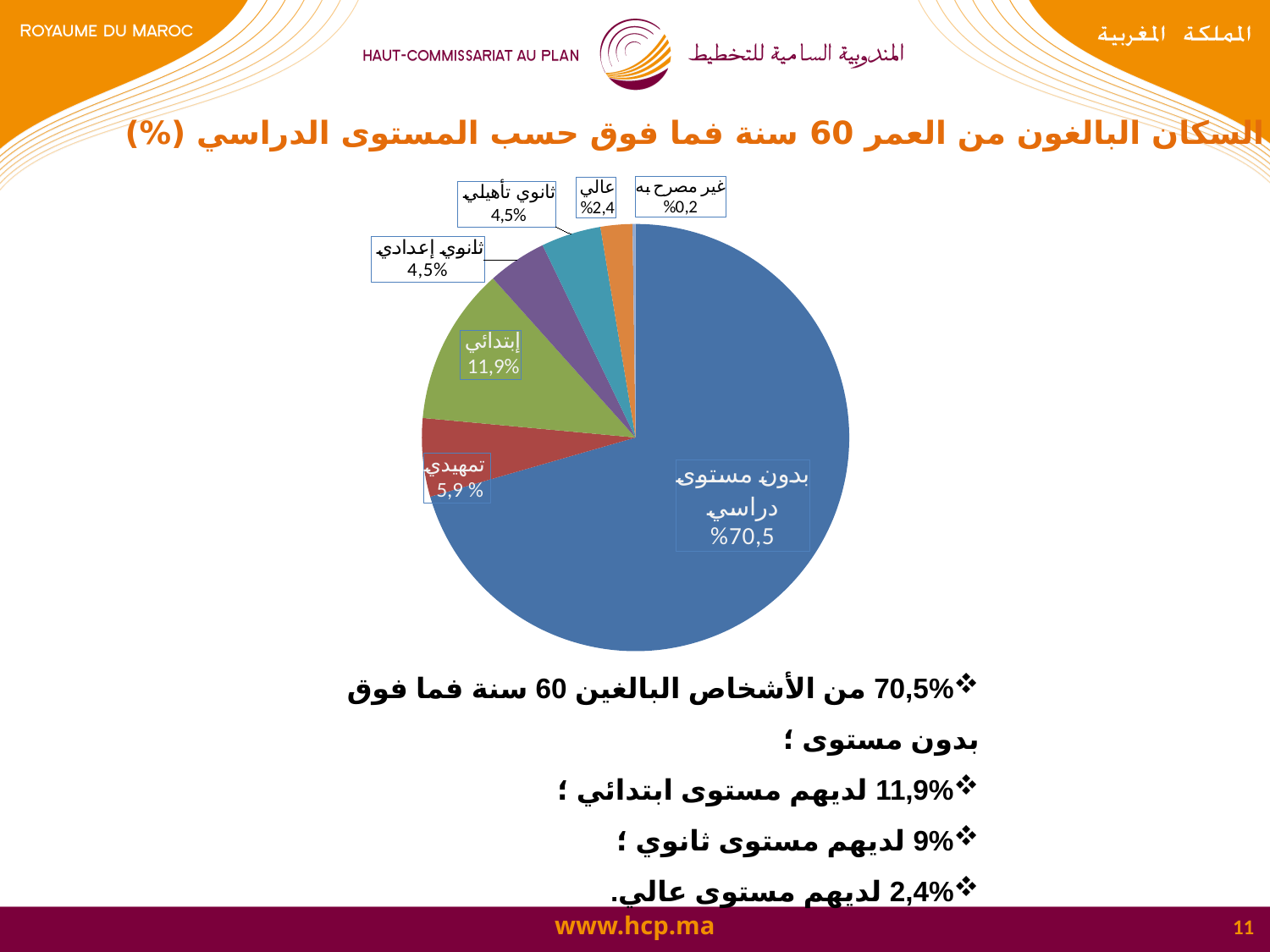
What is the value shown for 'إبتدائي'? 11,9% What type of chart is shown on the slide? pie chart What share of the pie is labelled 'بدون مستوى دراسي'? 70,5% What is the title of the chart? السكان البالغون من العمر 60 سنة فما فوق حسب المستوى الدراسي (%) What is the value shown for 'تمهيدي'? 5,9% What is the difference between the values for 'إبتدائي' and 'تمهيدي'? 6 percentage points Which is larger, the value for 'ثانوي إعدادي' or the value for 'عالي'? ثانوي إعدادي Which category has the smallest slice of the pie? غير مصرح به Which category has the largest slice of the pie? بدون مستوى دراسي How many slices does the pie chart have? 7 What is the value shown for 'غير مصرح به'? 0,2% What is the value shown for 'عالي'? 2,4%